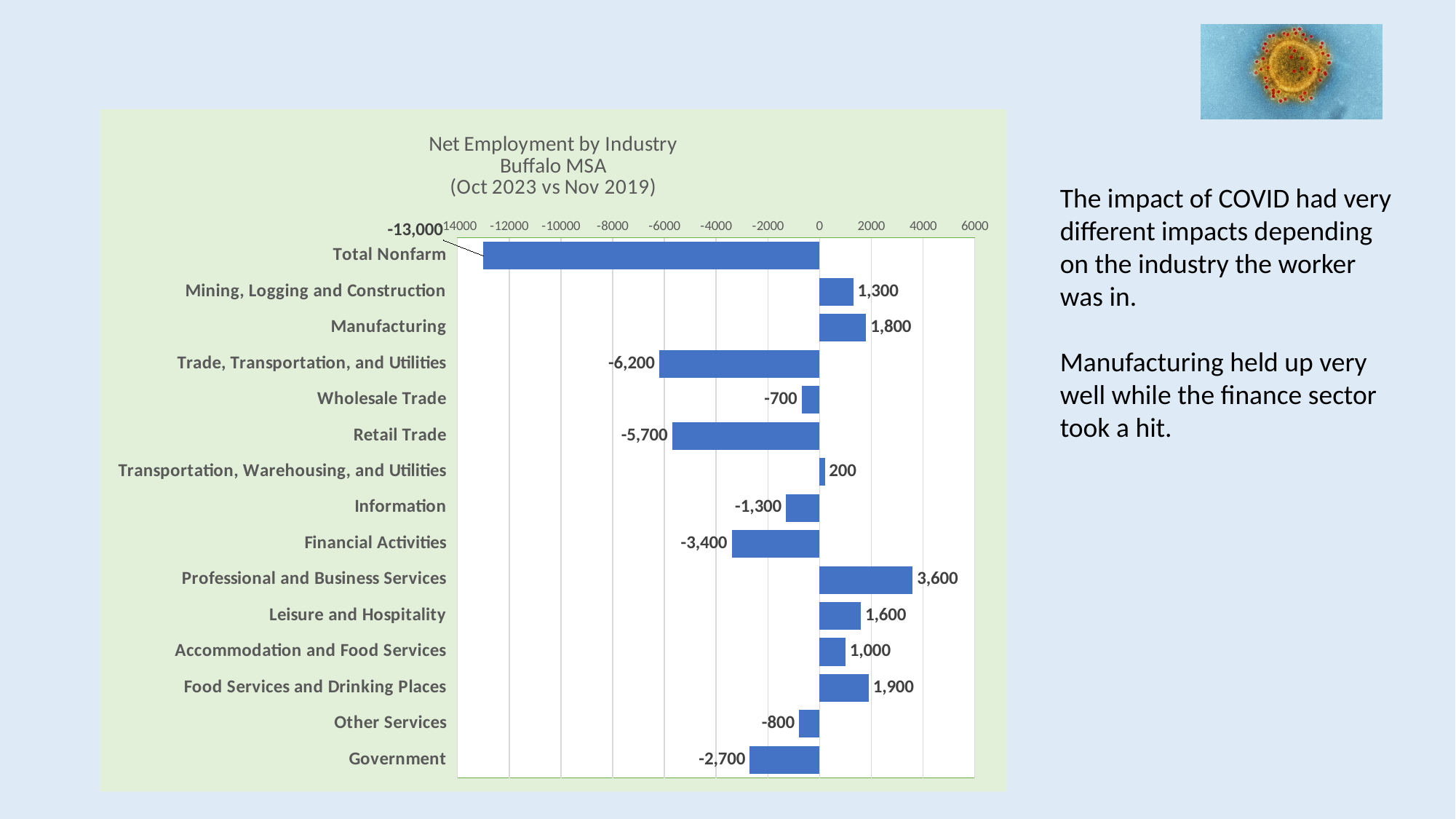
What is the title of the chart? Net Employment by Industry Buffalo MSA (Oct 2023 vs Nov 2019) Which is larger, the value for Leisure and Hospitality or the value for Mining, Logging and Construction? Leisure and Hospitality What is the difference between the values for Food Services and Drinking Places and Accommodation and Food Services? 900 What is the value for Financial Activities? -3,400 What is the value for Manufacturing? 1,800 Which category has the lowest value? Total Nonfarm What is the value for Retail Trade? -5,700 How many categories are shown on the chart? 15 What is the value for Total Nonfarm? -13,000 Which category has the highest value? Professional and Business Services What kind of chart is shown on the slide? bar chart Is the value for Trade, Transportation, and Utilities greater or less than -4000? less